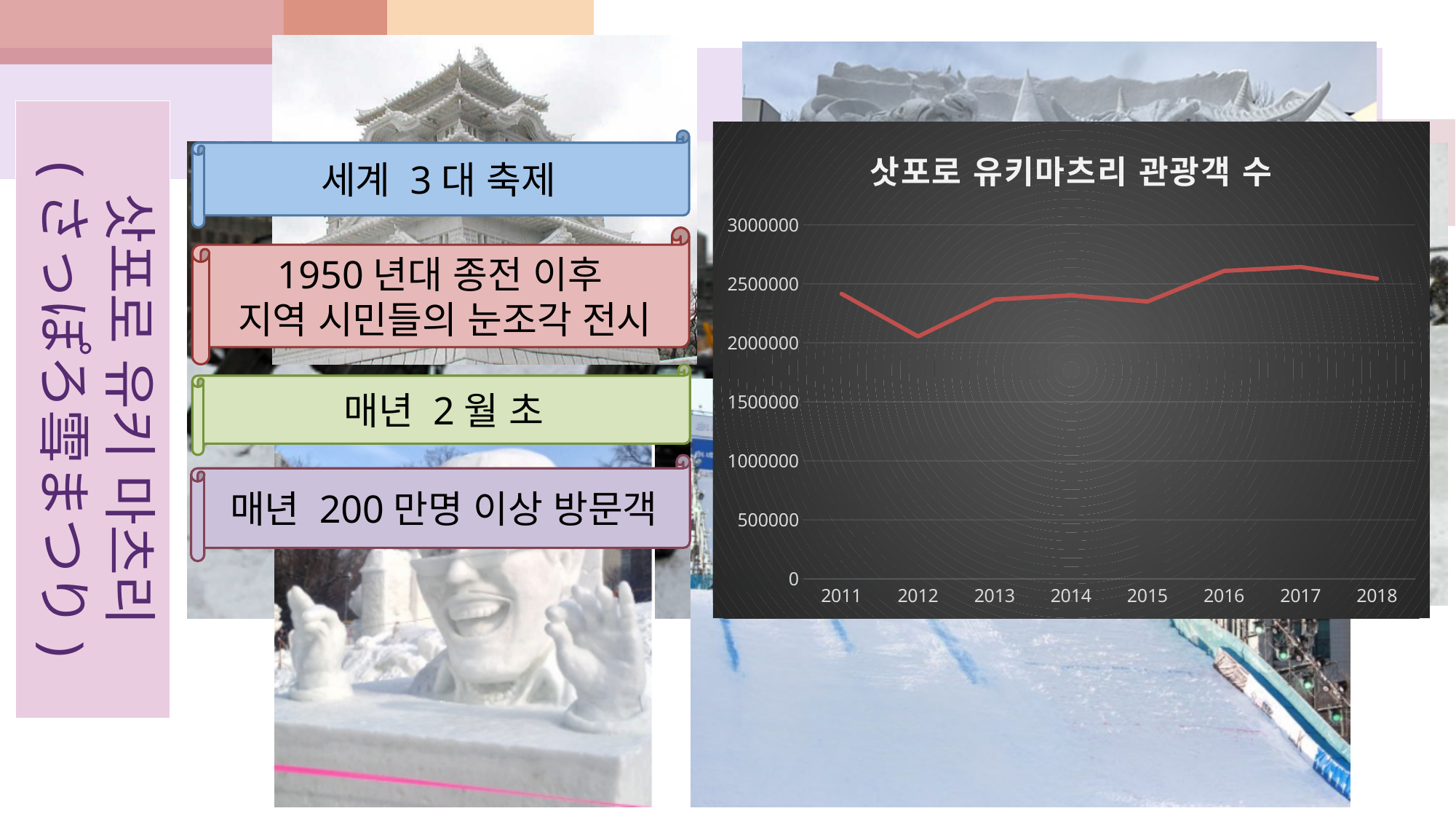
How many years are plotted on the x axis of the chart? 8 Which is larger, the value for 2015 or the value for 2017? 2017 What is the title of the chart? 삿포로 유키마츠리 관광객 수 Is the value for 2016 greater or less than 2500000? greater What kind of chart is shown on the slide? line chart Which is larger, the value for 2012 or the value for 2016? 2016 Is the value for 2018 greater or less than 3000000? less Is the value for 2012 greater or less than 2500000? less Does the line rise or fall from 2015 to 2017? rise Which year has the lowest value in the chart? 2012 Does the line rise or fall from 2011 to 2012? fall